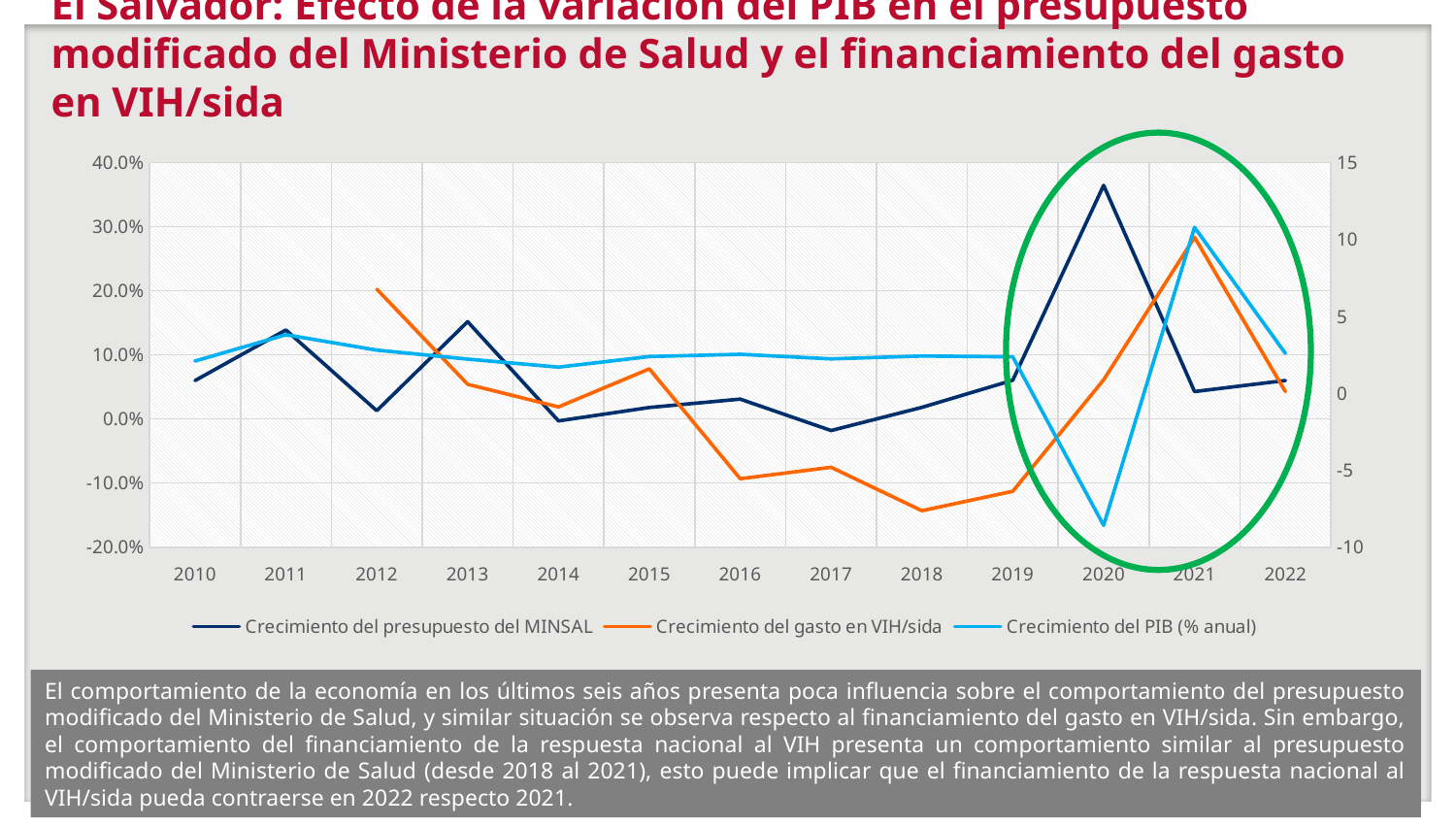
In 2021, which series has the higher value: 'Crecimiento del presupuesto del MINSAL' or 'Crecimiento del gasto en VIH/sida'? Crecimiento del gasto en VIH/sida Does the 'Crecimiento del gasto en VIH/sida' series rise or fall from 2018 to 2021? Rise How many years are shown on the x axis? 13 In which year does the 'Crecimiento del PIB (% anual)' series reach its lowest value? 2020 In which year does the 'Crecimiento del presupuesto del MINSAL' series reach its highest value? 2020 How many series does the legend list? 3 What kind of chart is shown on the slide? Line chart In which year does the 'Crecimiento del gasto en VIH/sida' series reach its highest value? 2021 In which year does the 'Crecimiento del gasto en VIH/sida' series reach its lowest value? 2018 Which colour is used for the 'Crecimiento del gasto en VIH/sida' line? Orange Is the value for 'Crecimiento del presupuesto del MINSAL' in 2020 greater or less than 30.0%? greater Is the value for 'Crecimiento del gasto en VIH/sida' in 2018 greater or less than -10.0%? less